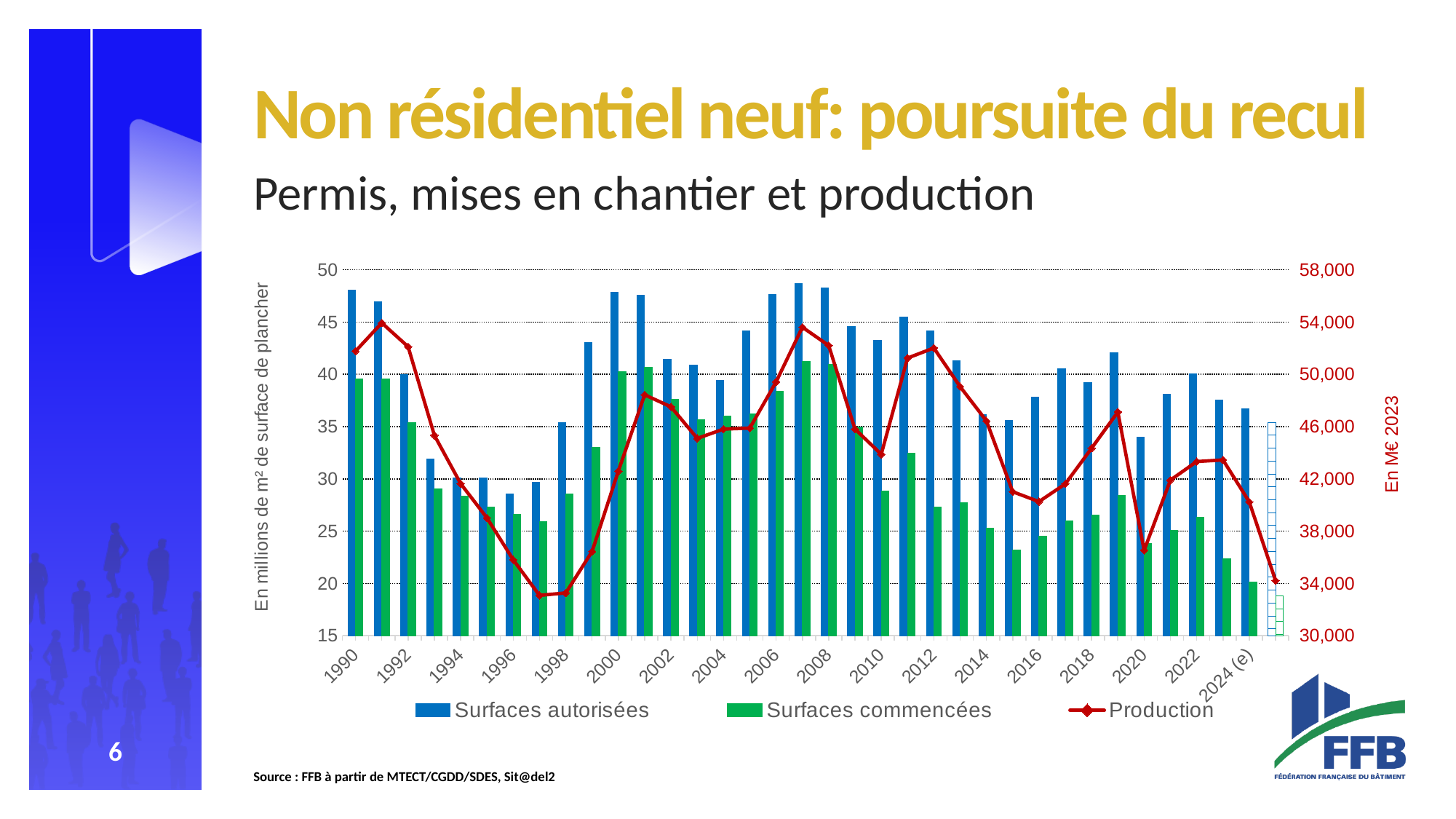
Is the value of Surfaces commencées in 1997 greater or less than 30? less What kind of chart is shown on the slide? A combined bar and line chart Which is larger, Surfaces autorisées in 1990 or in 1996? 1990 What is the label of the left vertical axis? En millions de m² de surface de plancher Which series is plotted as a red line with diamond markers? Production Does Production rise or fall from 2012 to 2016? Fall Is the value of Production in 2016 greater or less than 42,000? less Is the value of Surfaces autorisées in 1990 greater or less than 45? greater How many series does the chart legend list? 3